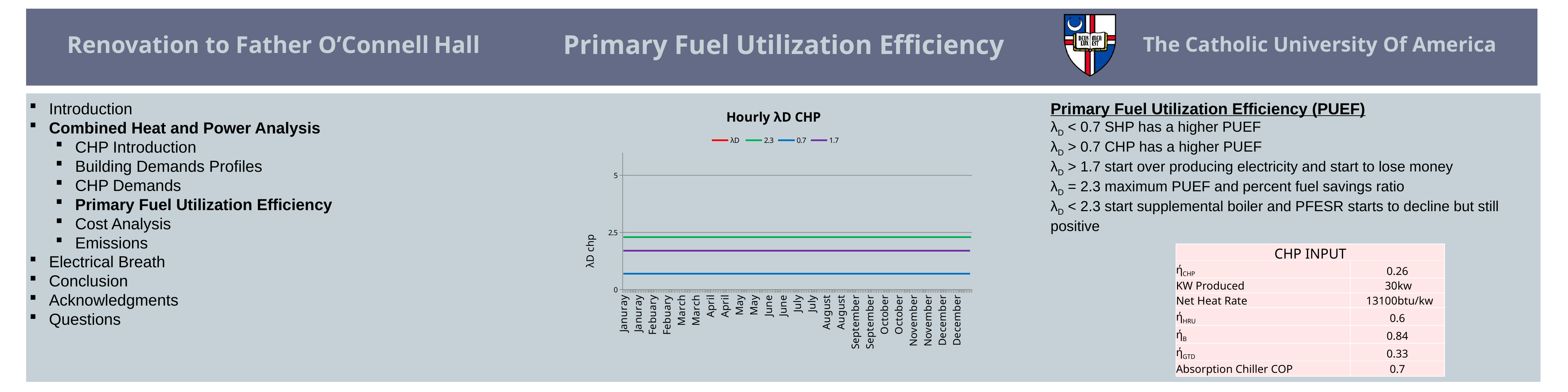
Of the 2.3, 1.7 and 0.7 series, which line is plotted lowest on the chart? 0.7 What is the title of the chart? Hourly λD CHP Does the 2.3 series rise, fall, or stay flat across the months on the x axis? stays flat Which is higher on the chart, the 1.7 series or the 0.7 series? 1.7 What kind of chart is shown on the slide? line chart What is the label on the vertical axis of the chart? λD chp Is the value of the 1.7 series greater or less than 2.5? less Is the value of the 0.7 series greater or less than 2.5? less How many series does the chart legend list? 4 Of the 2.3, 1.7 and 0.7 series, which line is plotted highest on the chart? 2.3 Is the value of the 2.3 series greater or less than 5? less Which is higher on the chart, the 2.3 series or the 0.7 series? 2.3